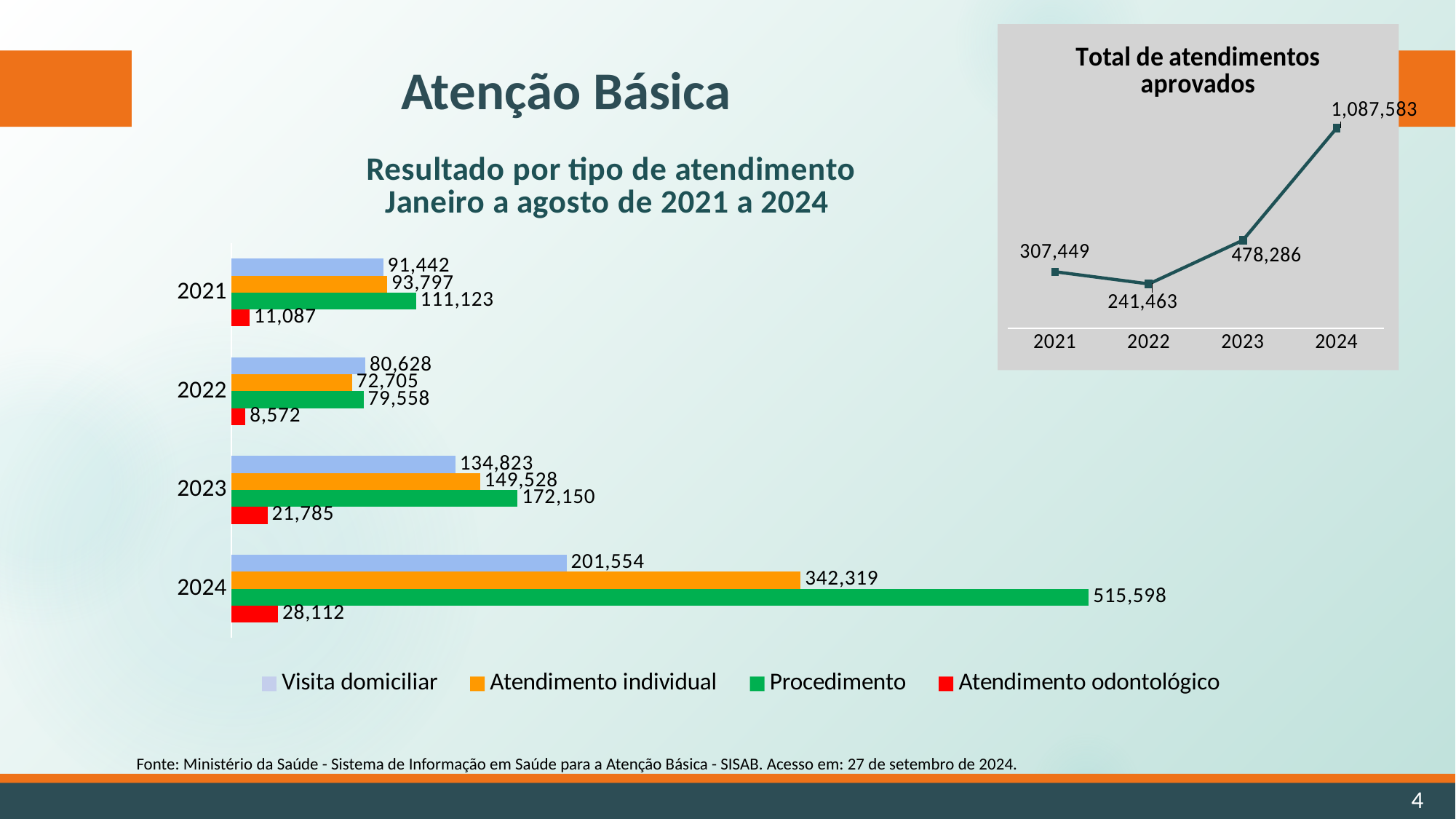
In the 'Resultado por tipo de atendimento' chart, what is the value for Visita domiciliar in 2023? 134,823 In the 'Resultado por tipo de atendimento' chart, which year has the lowest value for Procedimento? 2022 In the 'Resultado por tipo de atendimento' chart, what is the value for Procedimento in 2024? 515,598 In the 'Total de atendimentos aprovados' chart, which year has the lowest value? 2022 In the 'Resultado por tipo de atendimento' chart, what is the value for Atendimento odontológico in 2022? 8,572 In the 'Resultado por tipo de atendimento' chart, which year has the highest value for Atendimento individual? 2024 How many series does the legend of the 'Resultado por tipo de atendimento' chart list? 4 What kind of chart is the 'Resultado por tipo de atendimento' chart? Bar chart In the 'Resultado por tipo de atendimento' chart, which is larger in 2021: Visita domiciliar or Procedimento? Procedimento In the 'Total de atendimentos aprovados' chart, what is the value for 2023? 478,286 In the 'Total de atendimentos aprovados' chart, what is the difference between the 2024 and 2021 values? 780,134 In the 'Resultado por tipo de atendimento' chart, what is the difference between Atendimento individual in 2024 and in 2023? 192,791